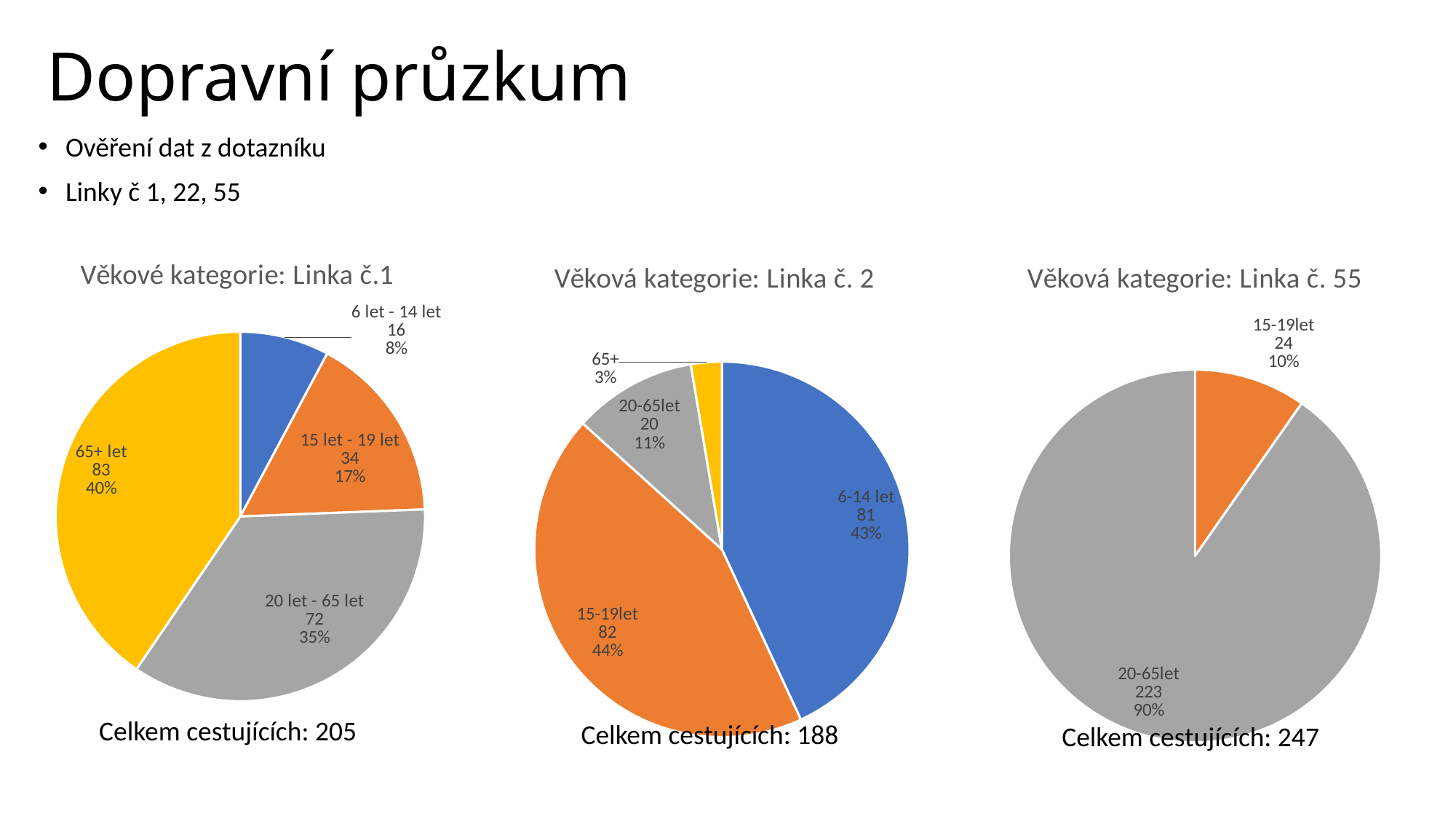
In the chart 'Věková kategorie: Linka č. 55', what is the value for '20-65let'? 223 In the chart 'Věková kategorie: Linka č. 55', which category is larger, '15-19let' or '20-65let'? 20-65let What kind of chart is 'Věková kategorie: Linka č. 55'? Pie chart In the chart 'Věkové kategorie: Linka č.1', what is the difference between the values for '65+ let' and '15 let - 19 let'? 49 In the chart 'Věková kategorie: Linka č. 2', what share of the pie does '6-14 let' take? 43% In the chart 'Věková kategorie: Linka č. 2', how many categories are shown? 4 In the chart 'Věkové kategorie: Linka č.1', which category is the smallest? 6 let - 14 let In the chart 'Věkové kategorie: Linka č.1', what is the value for '65+ let'? 83 In the chart 'Věková kategorie: Linka č. 2', what is the value for '20-65let'? 20 In the chart 'Věkové kategorie: Linka č.1', what share of the pie does '20 let - 65 let' take? 35% How many pie charts are shown on the slide? 3 In the chart 'Věková kategorie: Linka č. 2', which category has the smallest share? 65+